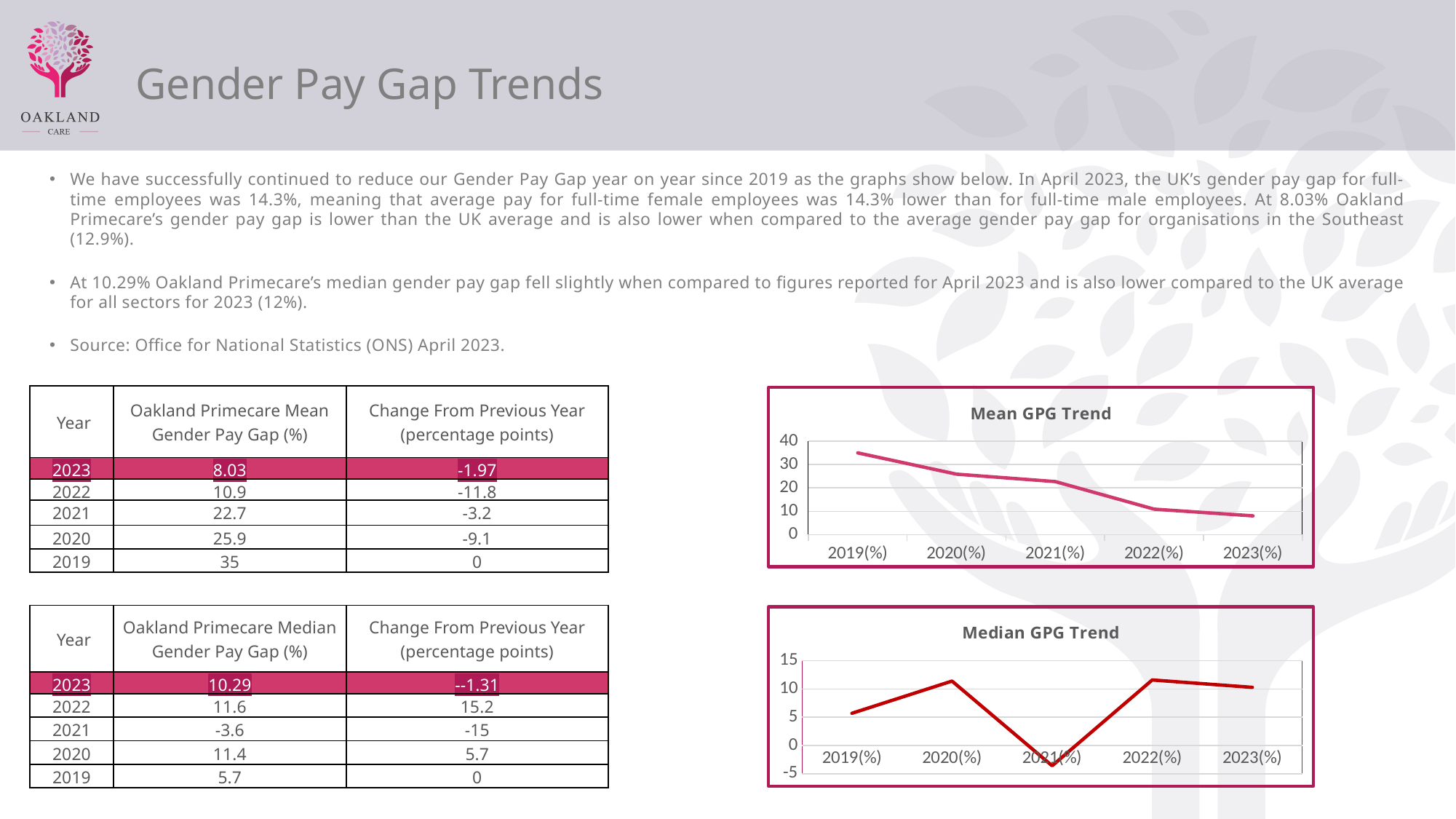
In the Median GPG Trend chart, which year has the lowest value? 2021(%) In the Mean GPG Trend chart, which is larger, the value for 2020(%) or the value for 2022(%)? 2020(%) In the Mean GPG Trend chart, how many years are plotted on the x axis? 5 In the Mean GPG Trend chart, do the values rise or fall from 2019(%) to 2023(%)? fall In the Mean GPG Trend chart, which year has the lowest value? 2023(%) In the Mean GPG Trend chart, is the value for 2022(%) greater or less than 20? less What type of chart is the Mean GPG Trend chart? line chart In the Mean GPG Trend chart, which year has the highest value? 2019(%) In the Median GPG Trend chart, is the value for 2020(%) greater or less than 10? greater What is the title of the lower chart on the slide? Median GPG Trend In the Mean GPG Trend chart, is the value for 2019(%) greater or less than 30? greater